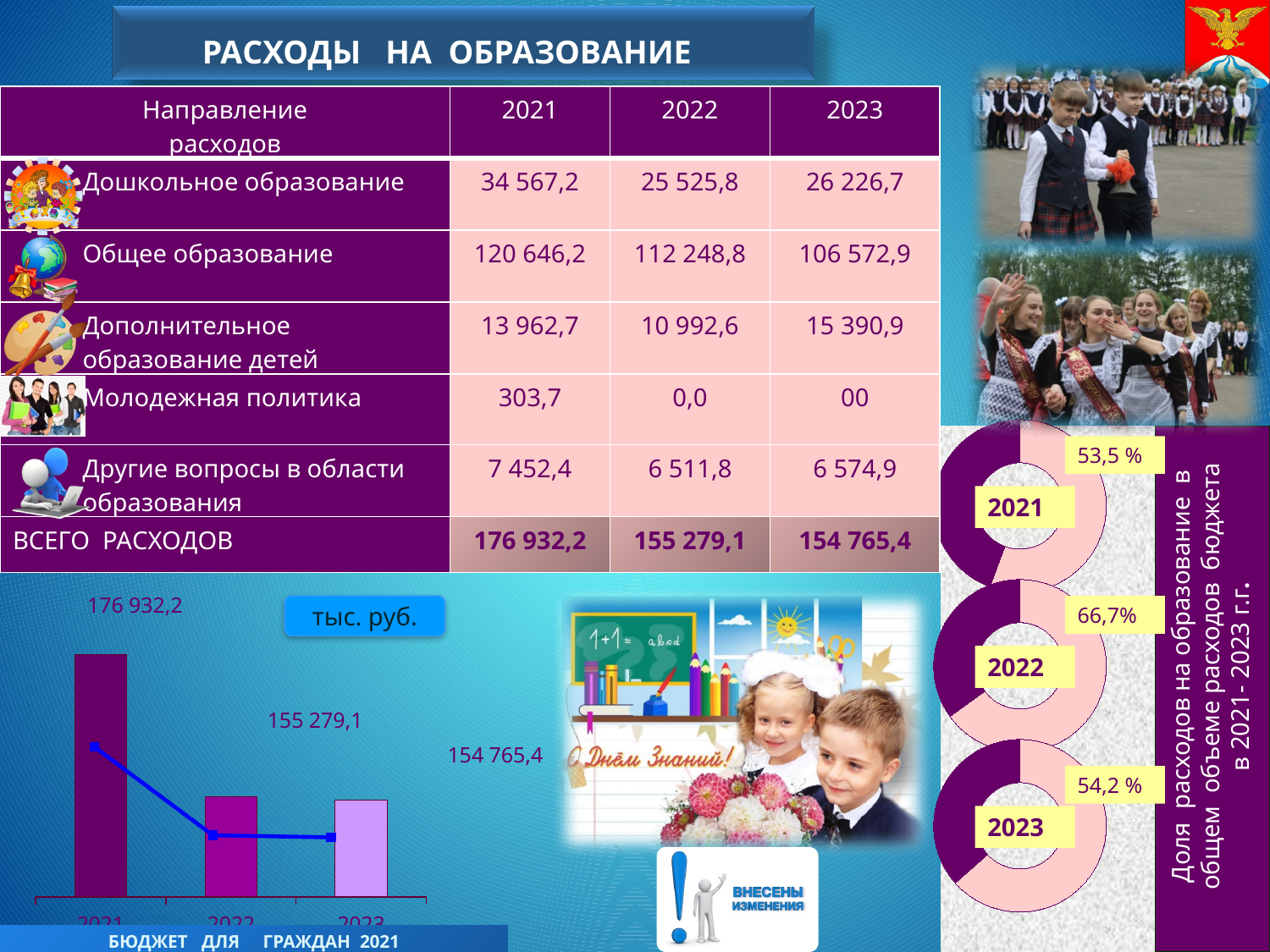
In the bar chart at the bottom left, which year has the highest value? 2021 In the bar chart at the bottom left, what is the difference between the values for 2021 and 2022? 21 653,1 In the bar chart at the bottom left, what is the value for 2021? 176 932,2 In the bar chart at the bottom left, which is larger, the value for 2022 or the value for 2023? 2022 What kind of chart is shown at the bottom left of the slide? bar chart What unit is indicated for the bar chart at the bottom left? тыс. руб. How many years are shown in the bar chart at the bottom left? 3 In the bar chart at the bottom left, what is the value for 2023? 154 765,4 In the donut charts on the right, which year has the highest share? 2022 In the bar chart at the bottom left, which year has the lowest value? 2023 In the donut charts on the right, what share is shown for 2022? 66,7% In the bar chart at the bottom left, do the values rise or fall from 2021 to 2023? fall